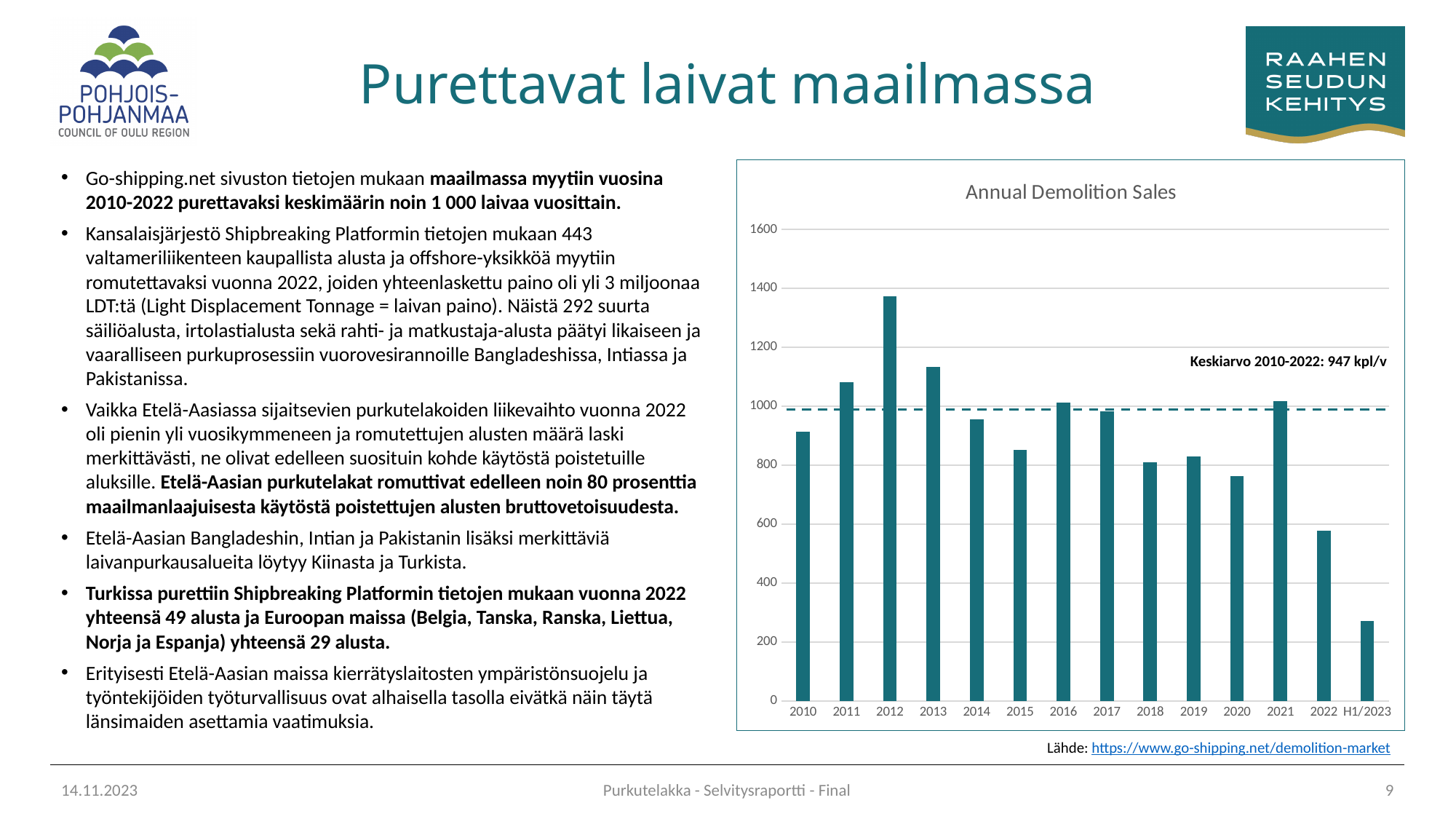
Which is larger, the value for 2012 or the value for 2013? 2012 What average value does the dashed line label in the chart state for 2010-2022? 947 kpl/v What is the title of the chart? Annual Demolition Sales Is the value for 2020 greater or less than 800? less Is the value for 2012 greater or less than 1200? greater Which category has the lowest value in the chart? H1/2023 How many categories are shown on the x axis of the chart? 14 Is the value for H1/2023 greater or less than 400? less What type of chart is shown on the slide? Bar chart Which year has the highest value in the chart? 2012 Do the values rise or fall from 2012 to 2015? fall